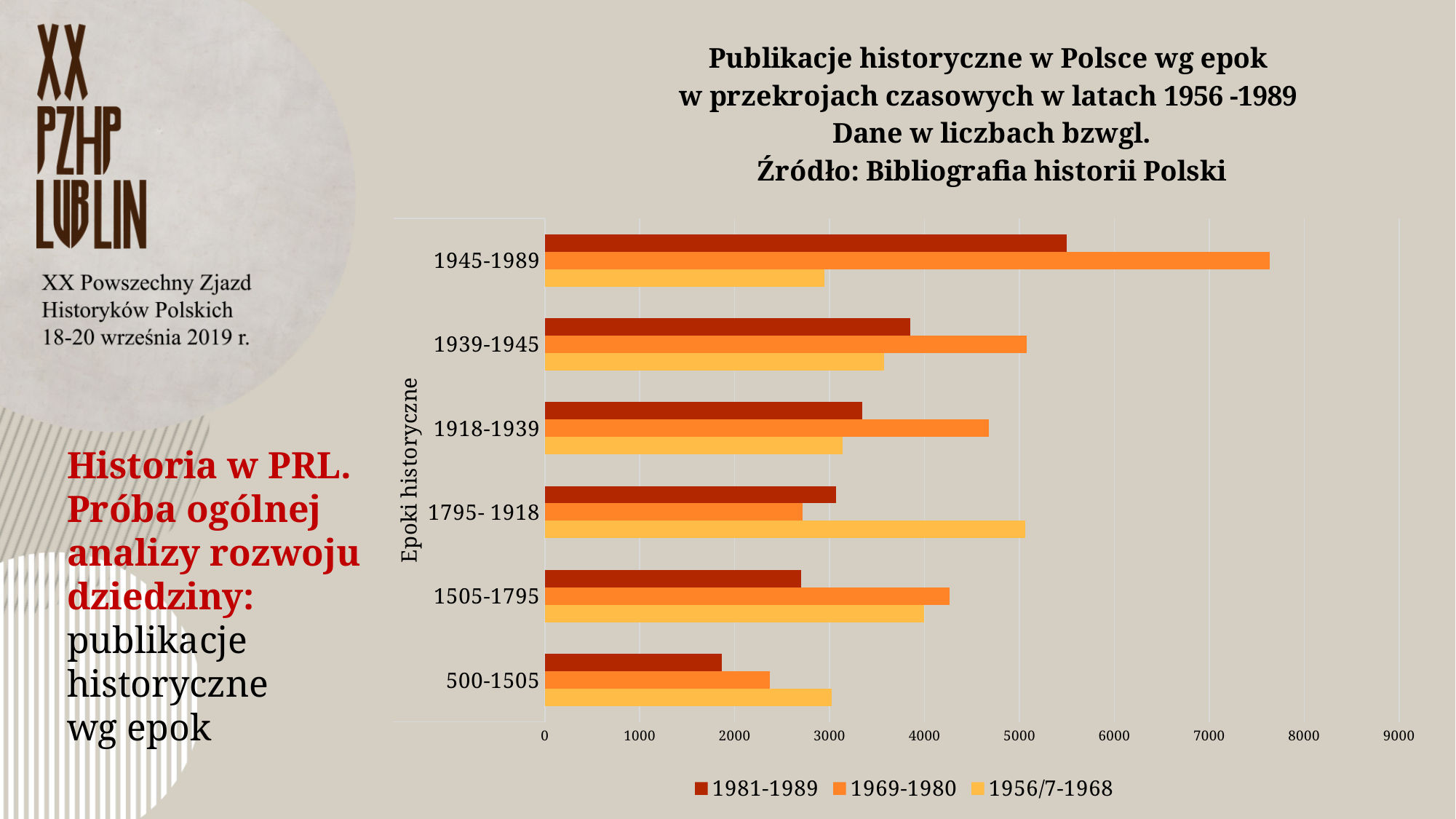
Is the value for 1945-1989 in the 1969-1980 series greater or less than 7000? greater For the epoch 1945-1989, which series has the larger value: 1981-1989 or 1956/7-1968? 1981-1989 Which epoch has the highest value for the 1969-1980 series? 1945-1989 Which epoch has the lowest value for the 1981-1989 series? 500-1505 What is the label of the vertical axis of the chart? Epoki historyczne How many series does the chart legend list? 3 For the epoch 1795- 1918, which series has the larger value: 1969-1980 or 1956/7-1968? 1956/7-1968 Is the value for 500-1505 in the 1981-1989 series greater or less than 2000? less What kind of chart is shown on the slide? bar chart Which epoch has the highest value for the 1956/7-1968 series? 1795- 1918 How many historical epochs (categories) are shown on the y axis of the chart? 6